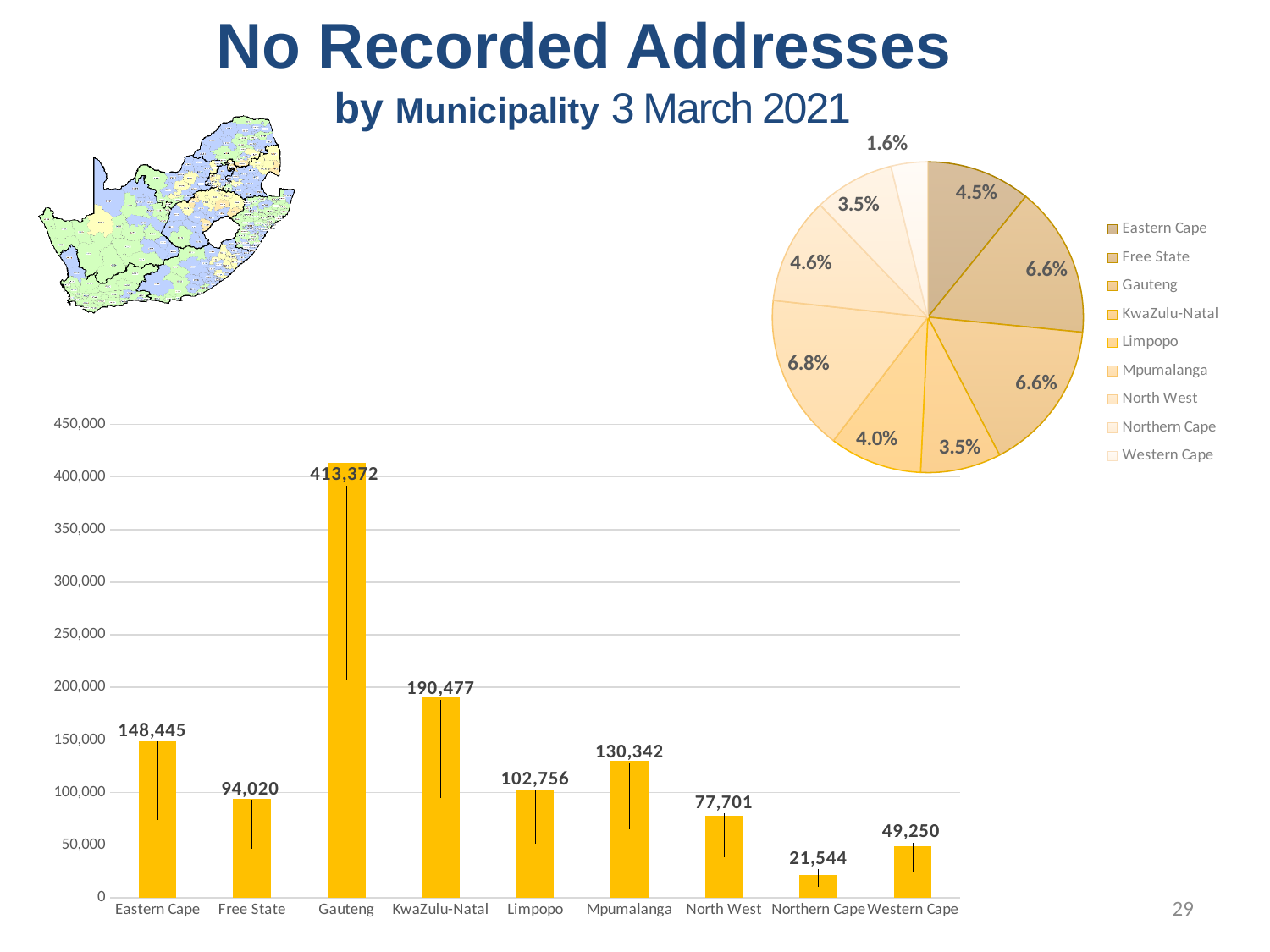
In the bar chart, what is the value for KwaZulu-Natal? 190,477 In the bar chart, which province has the highest value? Gauteng How many entries does the pie chart legend list? 9 In the pie chart, what percentage is shown for the Eastern Cape slice? 4.5% How many provinces are shown in the bar chart? 9 In the bar chart, which is larger, the value for Limpopo or the value for Mpumalanga? Mpumalanga What kind of chart is the chart at the bottom of the slide? bar chart In the bar chart, what is the value for Northern Cape? 21,544 In the bar chart, what is the difference between the values for Eastern Cape and Free State? 54,425 In the bar chart, which province has the lowest value? Northern Cape In the bar chart, is the value for Western Cape greater or less than 50,000? less In the bar chart, what is the value for Gauteng? 413,372